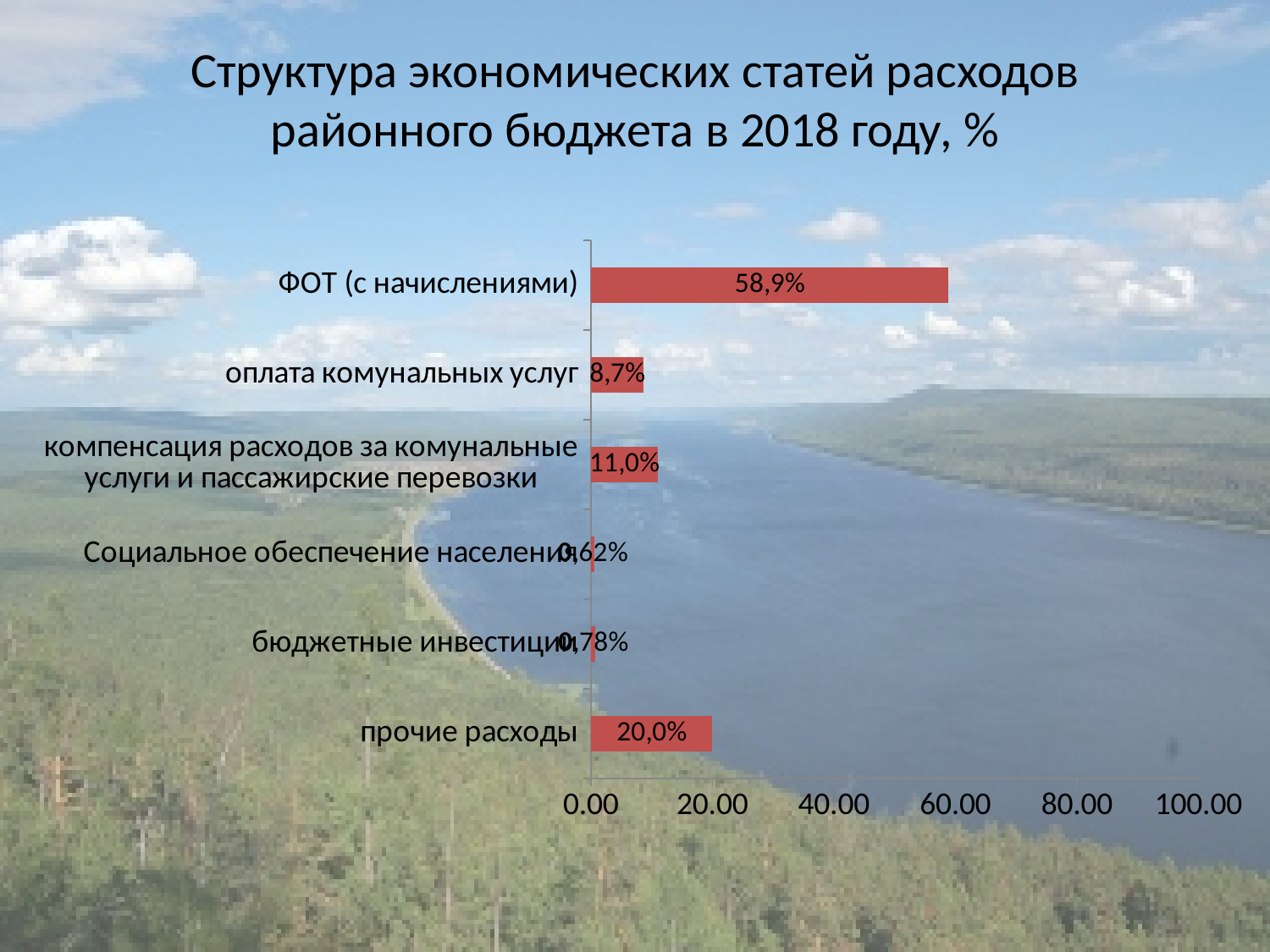
What is the value for бюджетные инвестиции? 0,78% Which category has the lowest value? Социальное обеспечение населения What is the value for прочие расходы? 20,0% Which is larger: the value for прочие расходы or the value for оплата комунальных услуг? прочие расходы What kind of chart is shown on the slide? bar chart What is the value for ФОТ (с начислениями)? 58,9% What is the value for компенсация расходов за комунальные услуги и пассажирские перевозки? 11,0% What is the value for оплата комунальных услуг? 8,7% Which category has the highest value? ФОТ (с начислениями) How many categories are shown in the chart? 6 What is the difference between the values for ФОТ (с начислениями) and прочие расходы? 38,9% Is the value for ФОТ (с начислениями) greater or less than 40.00? greater